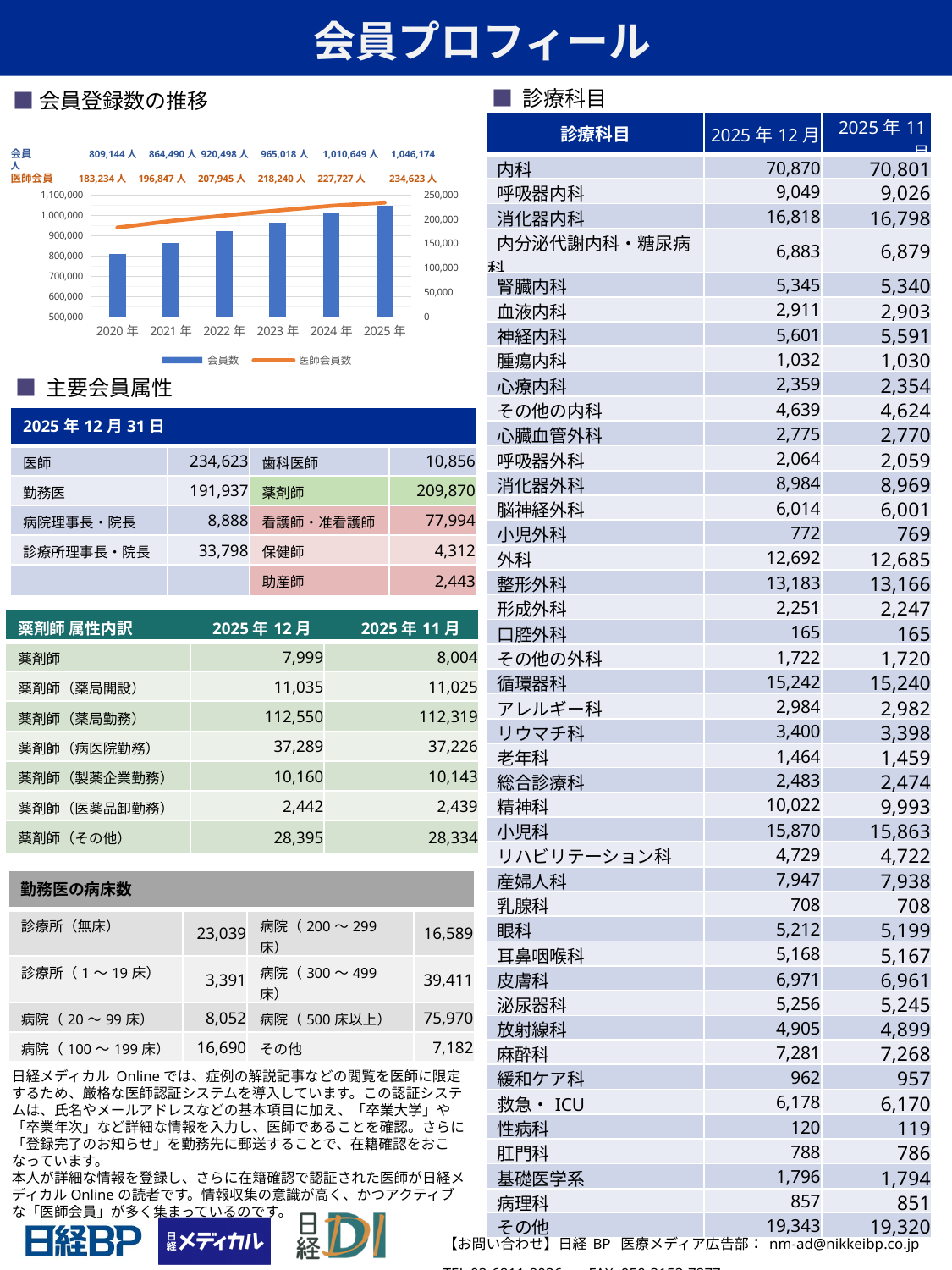
In the 会員登録数の推移 chart, which year has the lowest 医師会員数? 2020年 In the 会員登録数の推移 chart, is the 会員数 for 2024年 greater or less than 1,000,000? greater In the 会員登録数の推移 chart, which year has the highest 会員数? 2025年 In the 会員登録数の推移 chart, what is the difference in 会員数 between 2021年 and 2020年? 55,346人 In the 会員登録数の推移 chart, what is the 医師会員数 value for 2025年? 234,623人 Does the 会員数 in the 会員登録数の推移 chart rise or fall from 2020年 to 2025年? rise In the 会員登録数の推移 chart, what is the difference in 医師会員数 between 2025年 and 2024年? 6,896人 How many years are shown on the x axis of the 会員登録数の推移 chart? 6 In the 会員登録数の推移 chart, what is the 会員数 value for 2023年? 965,018人 In the 会員登録数の推移 chart, what is the 医師会員数 value for 2022年? 207,945人 How many series does the legend of the 会員登録数の推移 chart list? 2 In the 会員登録数の推移 chart, what is the 会員数 value for 2020年? 809,144人